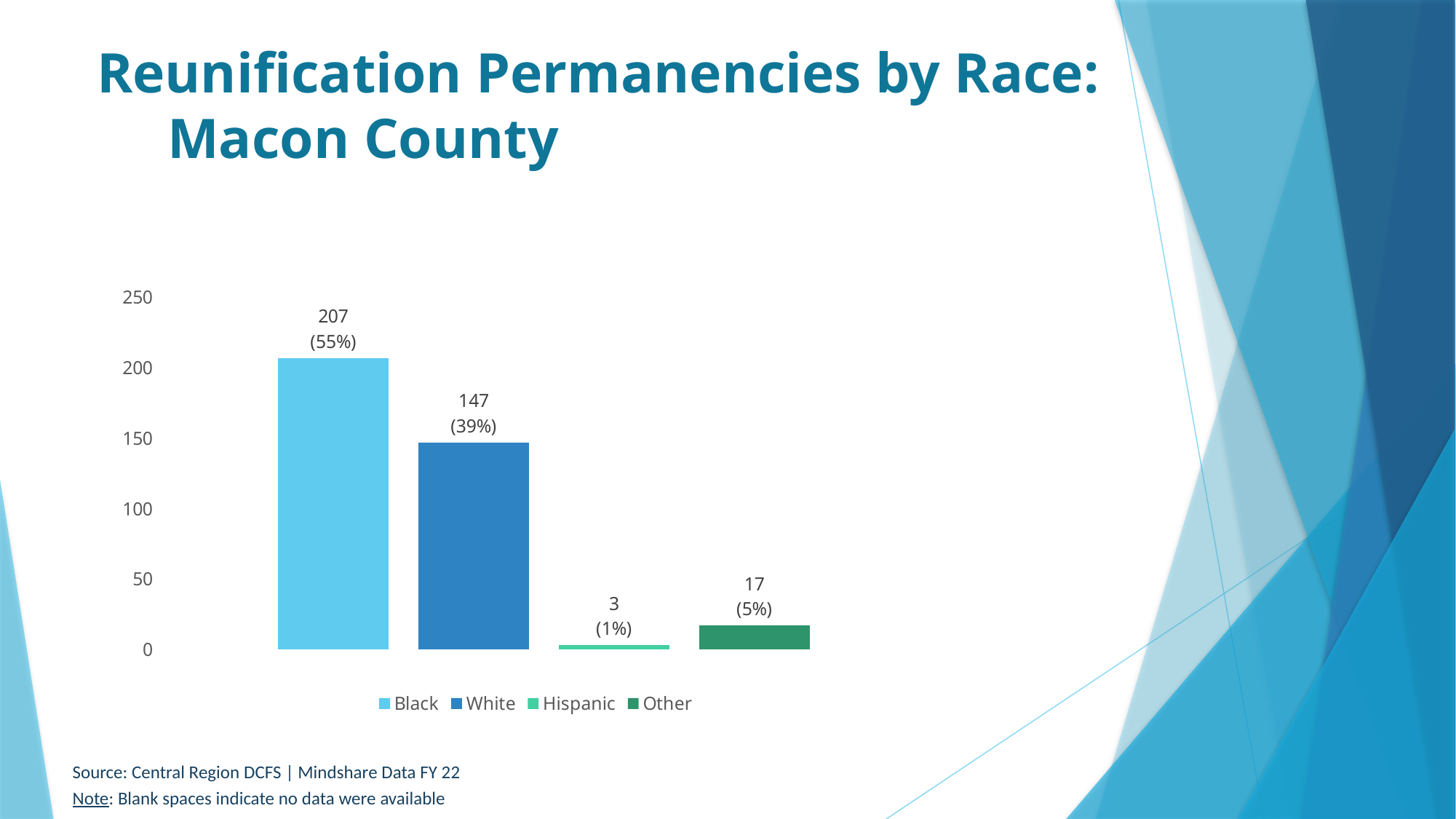
What kind of chart is shown on the slide? Bar chart What is the number of reunification permanencies for White children in Macon County? 147 What percentage is shown for the Black category? 55% Is the value for White greater or less than 100? greater Which race category has the lowest number of reunification permanencies? Hispanic Which race category has the highest number of reunification permanencies? Black How many race categories are plotted in the chart? 4 What is the difference between the Black and White values? 60 Which is larger, the value for Other or the value for Hispanic? Other What is the value shown for the Other category? 17 What is the number of reunification permanencies for Black children in Macon County? 207 What percentage of reunification permanencies is shown for Hispanic children? 1%